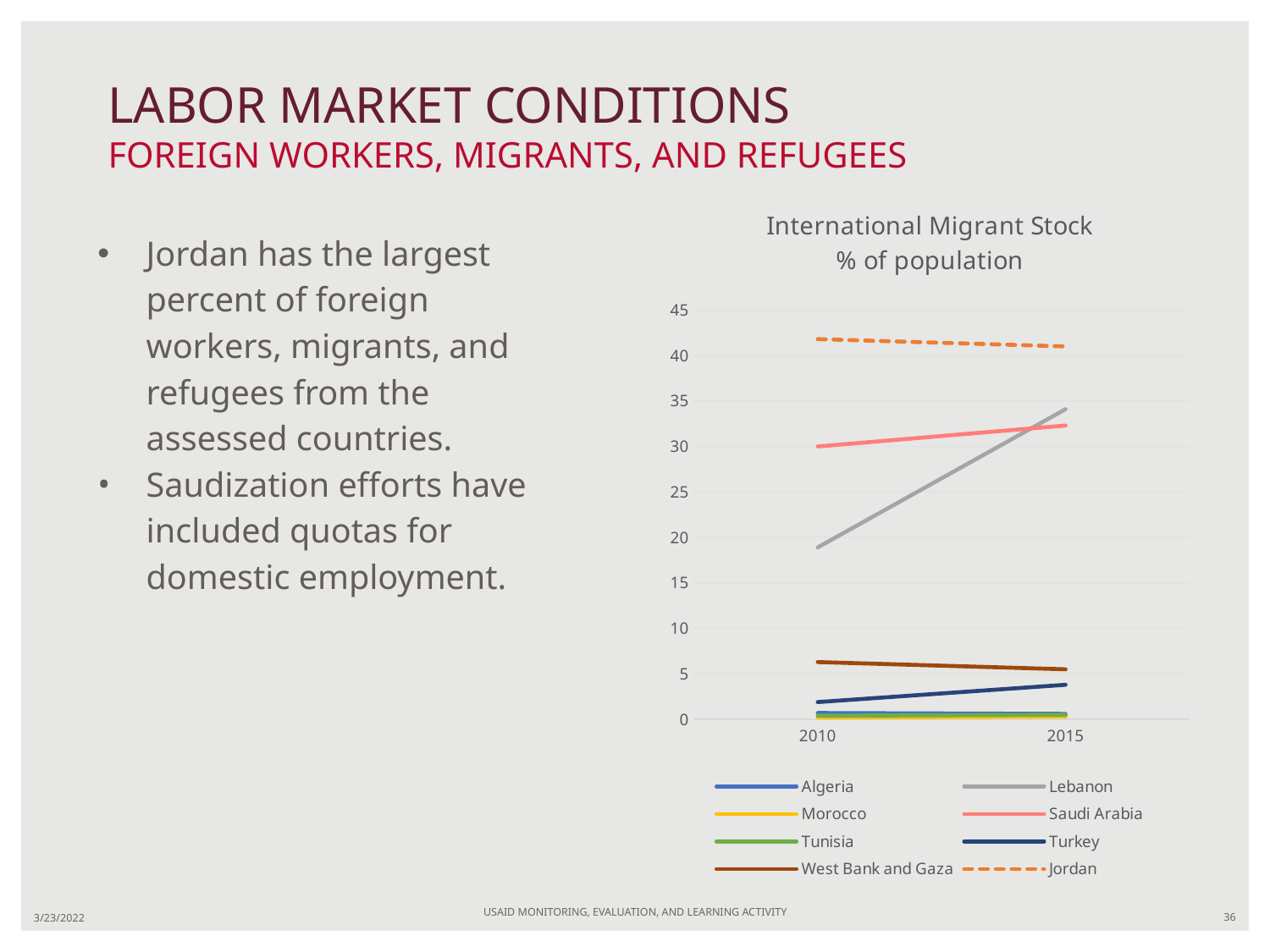
Is the value for Turkey in 2015 greater or less than 5? less Does the value for Lebanon rise or fall from 2010 to 2015? rise Which country has the highest international migrant stock as a percent of population in 2010? Jordan How many series does the legend list? 8 What kind of chart is shown on the slide? line chart Is the value for Jordan in 2010 greater or less than 40? greater In 2010, which is larger, the value for Saudi Arabia or the value for Lebanon? Saudi Arabia How many years are shown on the x axis? 2 Is the value for Lebanon in 2010 greater or less than 20? less What is the title of the chart? International Migrant Stock % of population Does the value for West Bank and Gaza rise or fall from 2010 to 2015? fall Which country has the highest international migrant stock as a percent of population in 2015? Jordan